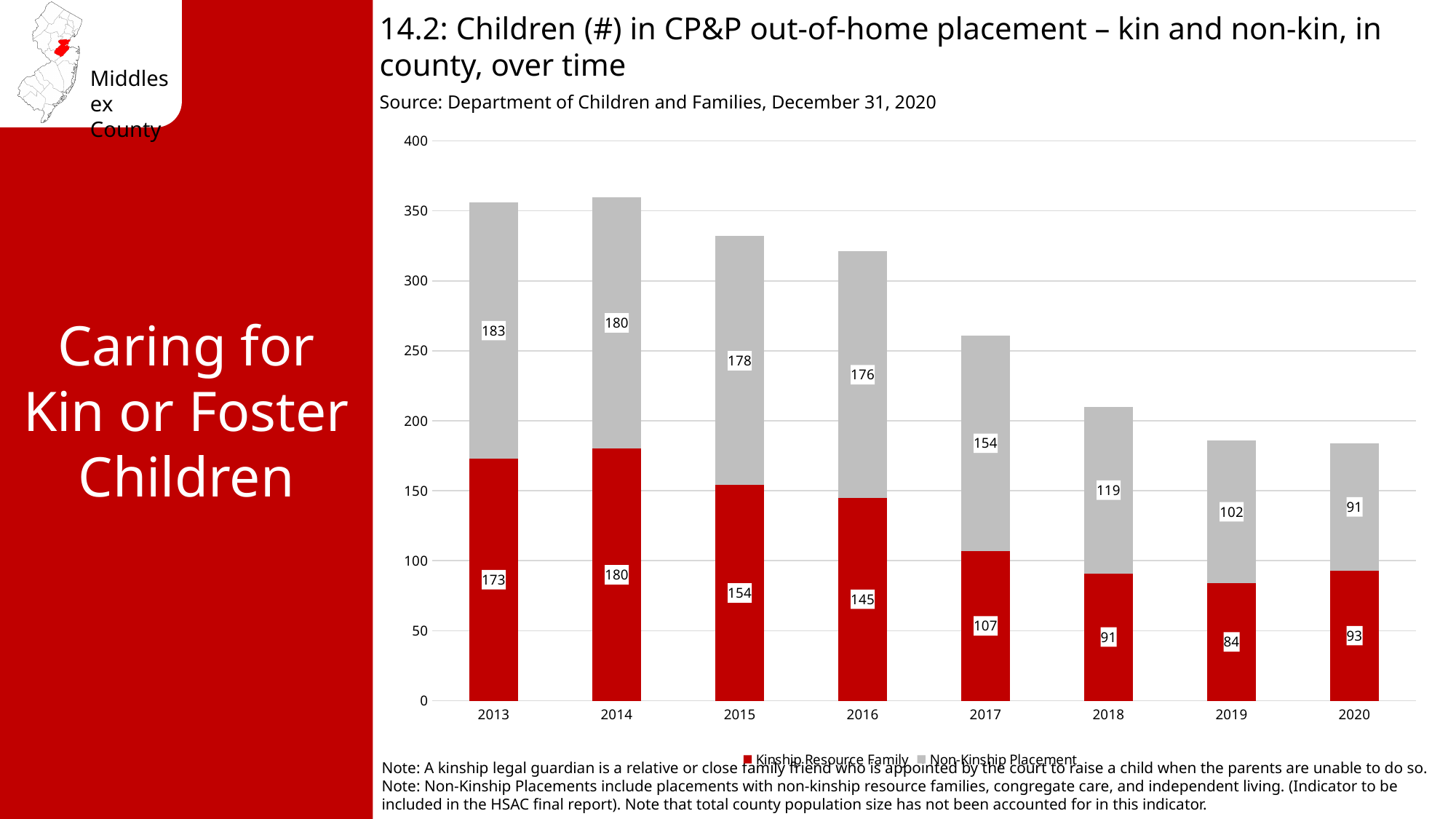
Which is larger in 2017: the Kinship Resource Family value or the Non-Kinship Placement value? Non-Kinship Placement What is the Kinship Resource Family value for 2016? 145 Which year has the highest Non-Kinship Placement value? 2013 What is the Non-Kinship Placement value for 2018? 119 Which year has the lowest Kinship Resource Family value? 2019 What is the difference between the Non-Kinship Placement values for 2013 and 2020? 92 How many series does the legend list? 2 Do the Kinship Resource Family values generally rise or fall from 2014 to 2019? Fall What is the total of the stacked bar for 2020? 184 Is the total height of the 2014 stacked bar greater or less than 350? greater How many years are shown on the x axis? 8 What kind of chart is shown on the slide? Stacked bar chart